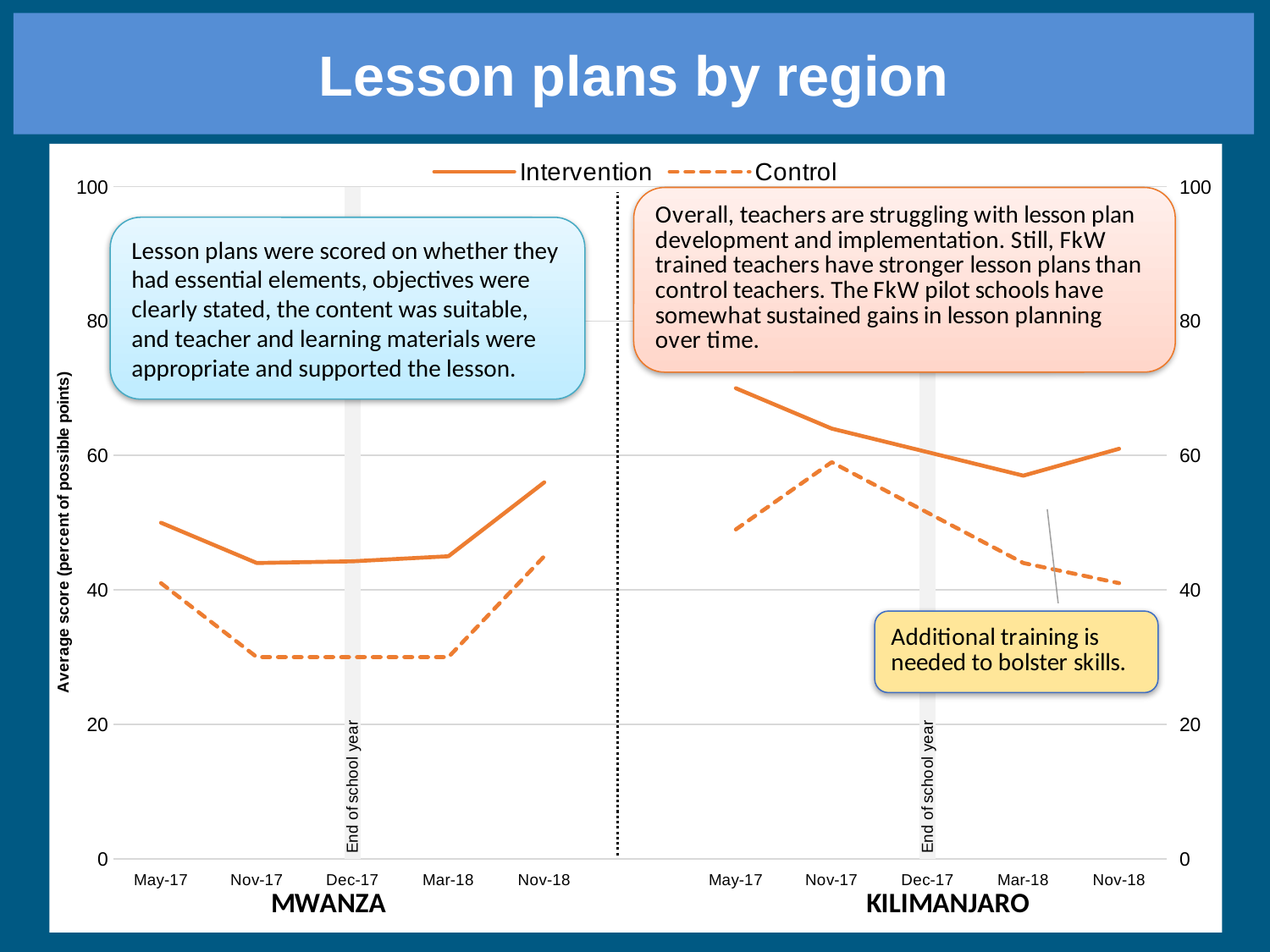
In the KILIMANJARO region, is the Control value for Nov-18 greater or less than 60? less In the MWANZA region, at which date is the Intervention series highest? Nov-18 In the KILIMANJARO region, at which date is the Intervention series highest? May-17 How many series does the legend list? 2 How many time points are plotted for the MWANZA region? 5 What kind of chart is shown on the slide? line chart In the KILIMANJARO region, is the Intervention value for May-17 greater or less than 60? greater In the KILIMANJARO region at Nov-17, which series has the higher value, Intervention or Control? Intervention In the KILIMANJARO region, does the Control series rise or fall from Nov-17 to Nov-18? fall What are the two series named in the legend? Intervention and Control In the MWANZA region, is the Control value for Nov-17 greater or less than 40? less In the MWANZA region at May-17, which series has the higher value, Intervention or Control? Intervention